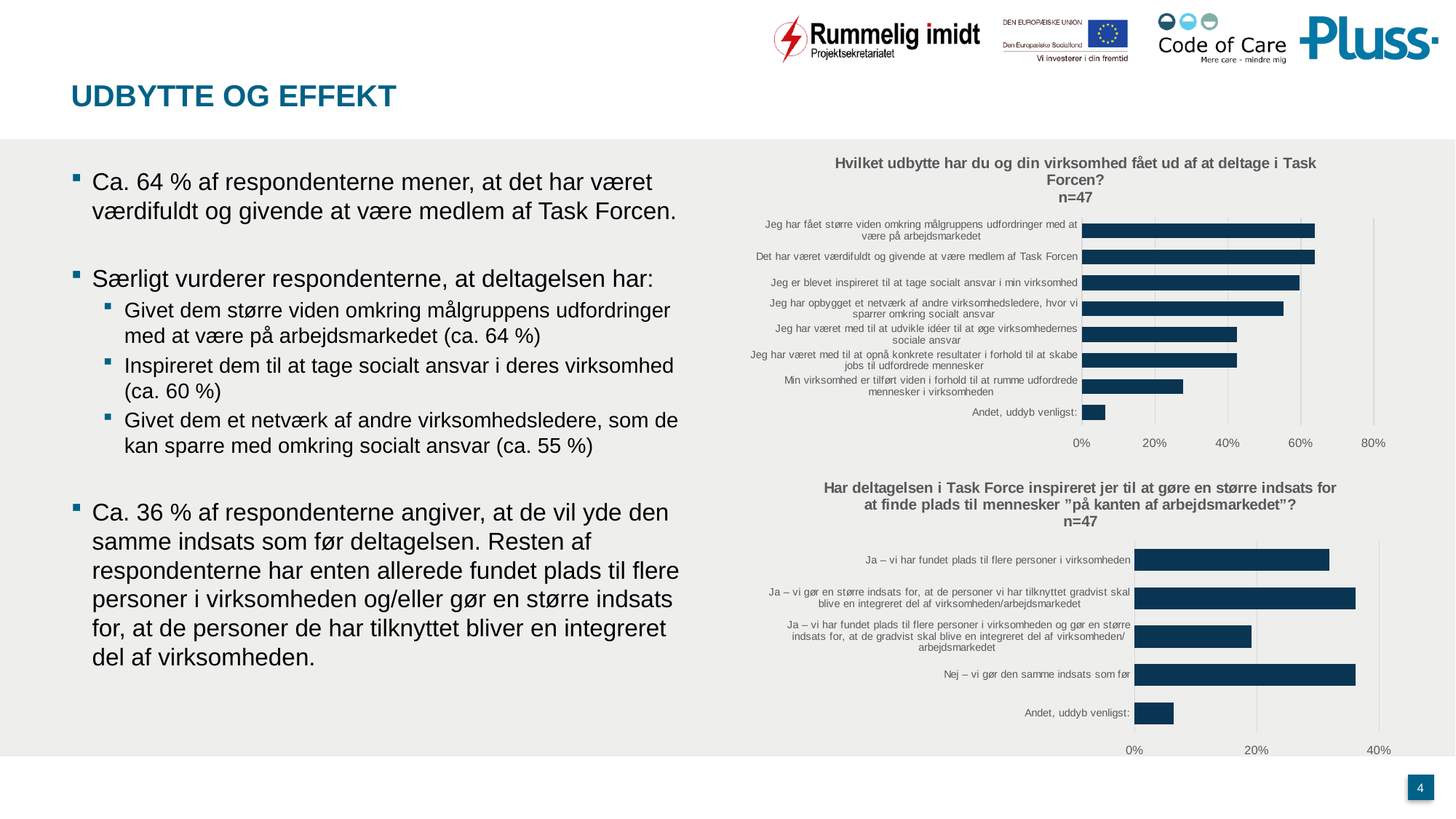
In the top chart ("Hvilket udbytte..."), what is the highest value shown on the x axis? 80% In the top chart ("Hvilket udbytte..."), which is larger: the value for "Jeg har opbygget et netværk af andre virksomhedsledere, hvor vi sparrer omkring socialt ansvar" or the value for "Jeg har været med til at udvikle idéer til at øge virksomhedernes sociale ansvar"? Jeg har opbygget et netværk af andre virksomhedsledere, hvor vi sparrer omkring socialt ansvar What kind of chart is the bottom chart, titled "Har deltagelsen i Task Force inspireret jer til at gøre en større indsats..."? Bar chart In the top chart ("Hvilket udbytte..."), which category has the lowest value? Andet, uddyb venligst: In the bottom chart ("Har deltagelsen i Task Force inspireret jer..."), what sample size (n) is stated in the chart title? n=47 In the top chart ("Hvilket udbytte..."), is the value for "Min virksomhed er tilført viden i forhold til at rumme udfordrede mennesker i virksomheden" greater or less than 40%? less What kind of chart is the top chart, titled "Hvilket udbytte har du og din virksomhed fået ud af at deltage i Task Forcen?"? Bar chart In the bottom chart ("Har deltagelsen i Task Force inspireret jer..."), is the value for "Ja – vi har fundet plads til flere personer i virksomheden" greater or less than 20%? greater In the bottom chart ("Har deltagelsen i Task Force inspireret jer..."), which category has the lowest value? Andet, uddyb venligst: In the top chart ("Hvilket udbytte..."), is the value for "Jeg har opbygget et netværk af andre virksomhedsledere, hvor vi sparrer omkring socialt ansvar" greater or less than 40%? greater In the bottom chart ("Har deltagelsen i Task Force inspireret jer..."), how many categories are plotted? 5 In the top chart ("Hvilket udbytte har du og din virksomhed fået ud af at deltage i Task Forcen?"), how many categories are plotted? 8